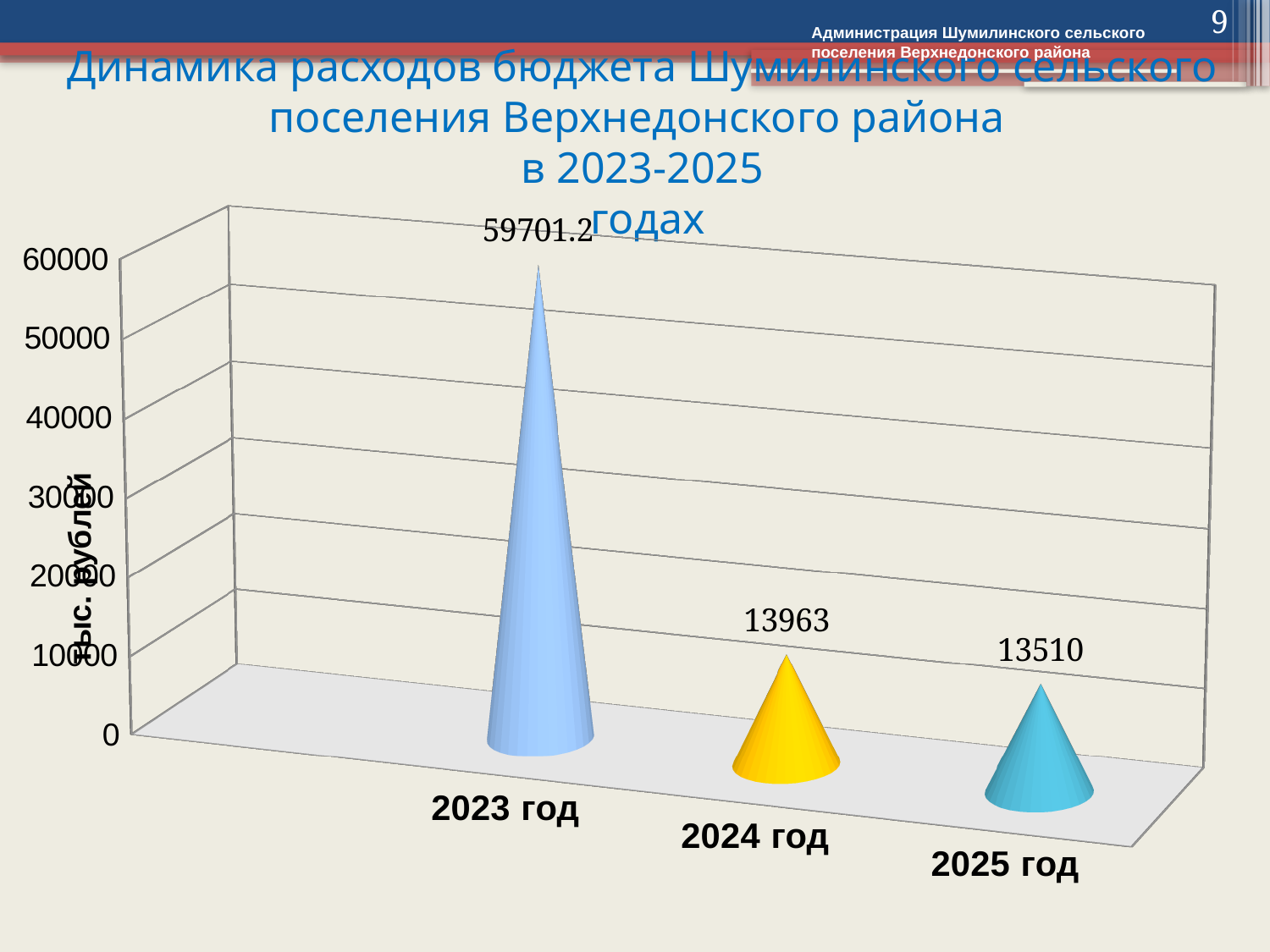
Is the value for 2024 год greater or less than 20000? less Do the values rise or fall from 2023 год to 2025 год? fall How many years are shown on the chart? 3 Which year has the highest value? 2023 год What is the value for 2025 год? 13510 What is the value for 2024 год? 13963 Which is larger, the value for 2023 год or the value for 2025 год? 2023 год What is the difference between the values for 2024 год and 2025 год? 453 What is the difference between the values for 2023 год and 2024 год? 45738.2 What is the value for 2023 год? 59701.2 Which year has the lowest value? 2025 год What unit is shown on the vertical axis label? тыс. рублей